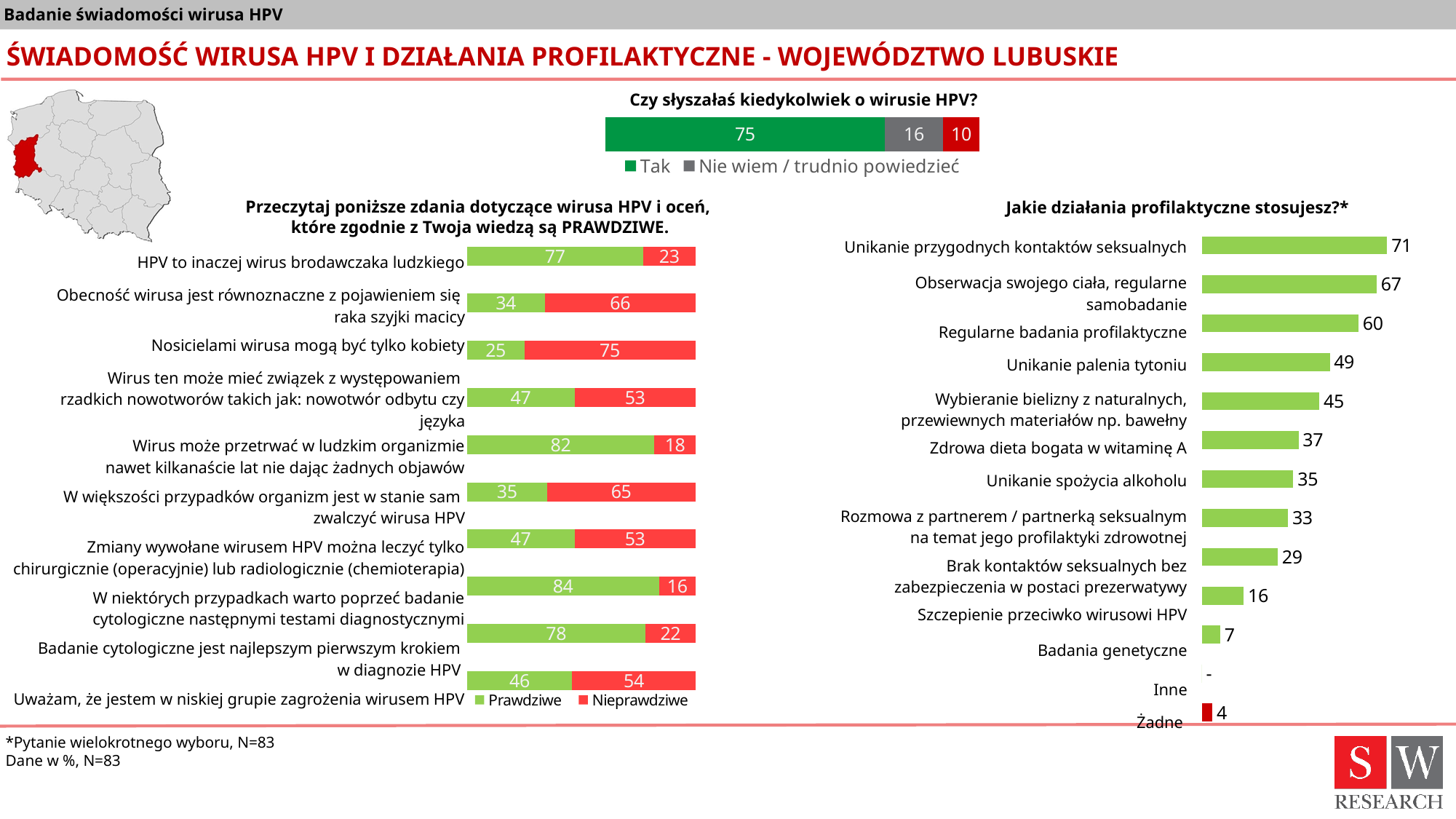
In the chart 'Przeczytaj poniższe zdania dotyczące wirusa HPV...', what is the 'Nieprawdziwe' value for 'HPV to inaczej wirus brodawczaka ludzkiego'? 23 What kind of chart is 'Jakie działania profilaktyczne stosujesz?'? Bar chart In the chart 'Jakie działania profilaktyczne stosujesz?', what is the difference between 'Regularne badania profilaktyczne' and 'Szczepienie przeciwko wirusowi HPV'? 44 In the chart 'Przeczytaj poniższe zdania dotyczące wirusa HPV...', what is the 'Prawdziwe' value for 'Nosicielami wirusa mogą być tylko kobiety'? 25 In the chart 'Jakie działania profilaktyczne stosujesz?', what is the value for 'Unikanie palenia tytoniu'? 49 How many categories are shown in the chart 'Jakie działania profilaktyczne stosujesz?'? 13 In the chart 'Przeczytaj poniższe zdania dotyczące wirusa HPV...', which statement has the highest 'Prawdziwe' value? W niektórych przypadkach warto poprzeć badanie cytologiczne następnymi testami diagnostycznymi In the chart 'Czy słyszałaś kiedykolwiek o wirusie HPV?', what is the value for 'Nie wiem / trudno powiedzieć'? 16 In the chart 'Jakie działania profilaktyczne stosujesz?', which category has the highest value? Unikanie przygodnych kontaktów seksualnych In the chart 'Czy słyszałaś kiedykolwiek o wirusie HPV?', what is the value for 'Tak'? 75 In the chart 'Jakie działania profilaktyczne stosujesz?', which is larger: 'Zdrowa dieta bogata w witaminę A' or 'Unikanie spożycia alkoholu'? Zdrowa dieta bogata w witaminę A How many series does the legend list in the chart 'Przeczytaj poniższe zdania dotyczące wirusa HPV...'? 2